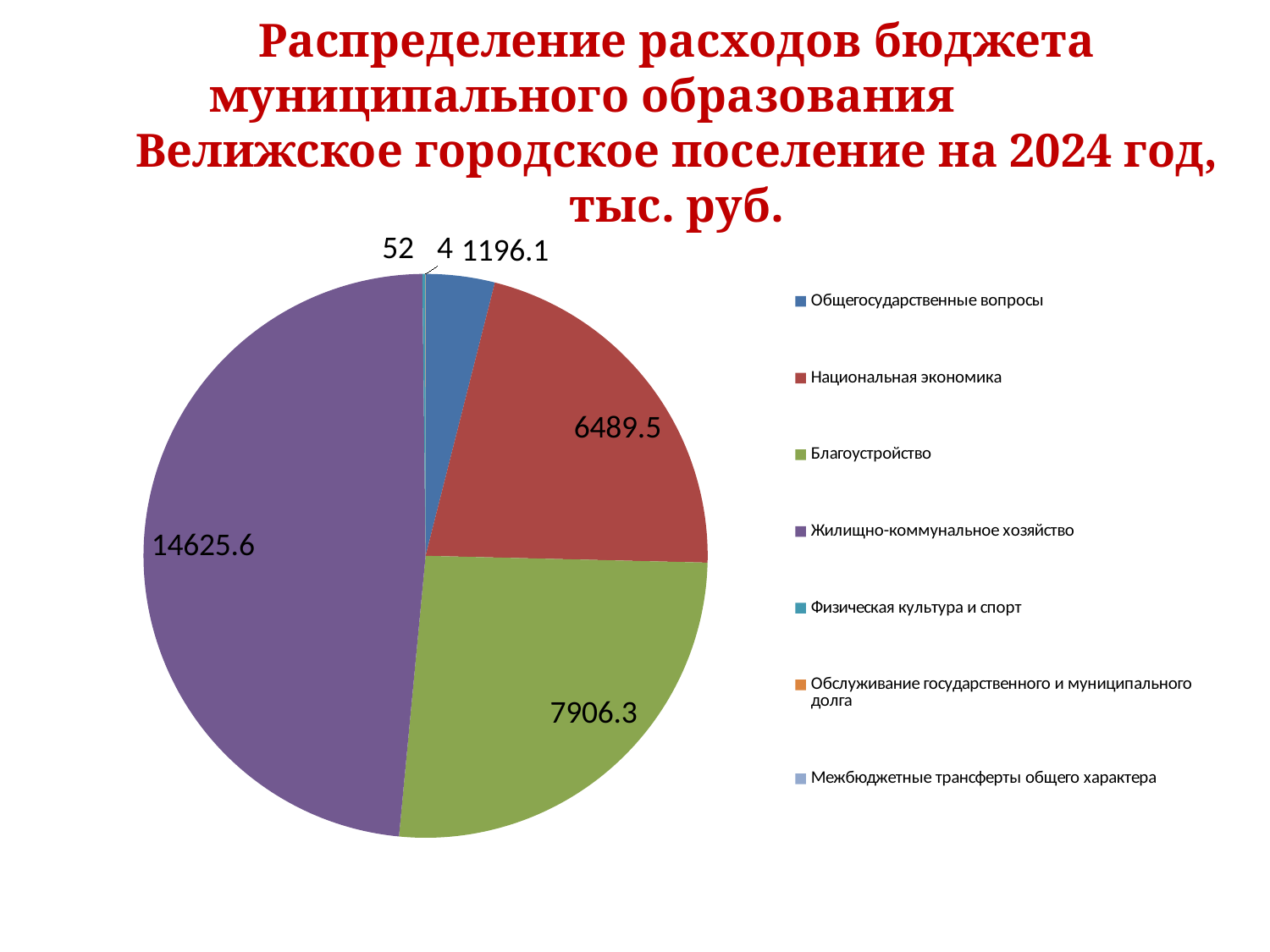
What is the value for Жилищно-коммунальное хозяйство? 14625.6 In what units are the values given, according to the chart title? тыс. руб. What is the value for Национальная экономика? 6489.5 Which is larger: Национальная экономика or Благоустройство? Благоустройство What is the value for Благоустройство? 7906.3 What is the difference between the values for Жилищно-коммунальное хозяйство and Благоустройство? 6719.3 What is the value for Общегосударственные вопросы? 1196.1 What is the difference between the values for Благоустройство and Национальная экономика? 1416.8 Which category has the largest slice of the pie? Жилищно-коммунальное хозяйство What kind of chart is shown on the slide? pie chart What colour is the slice for Жилищно-коммунальное хозяйство? purple How many categories does the legend of the pie chart list? 7